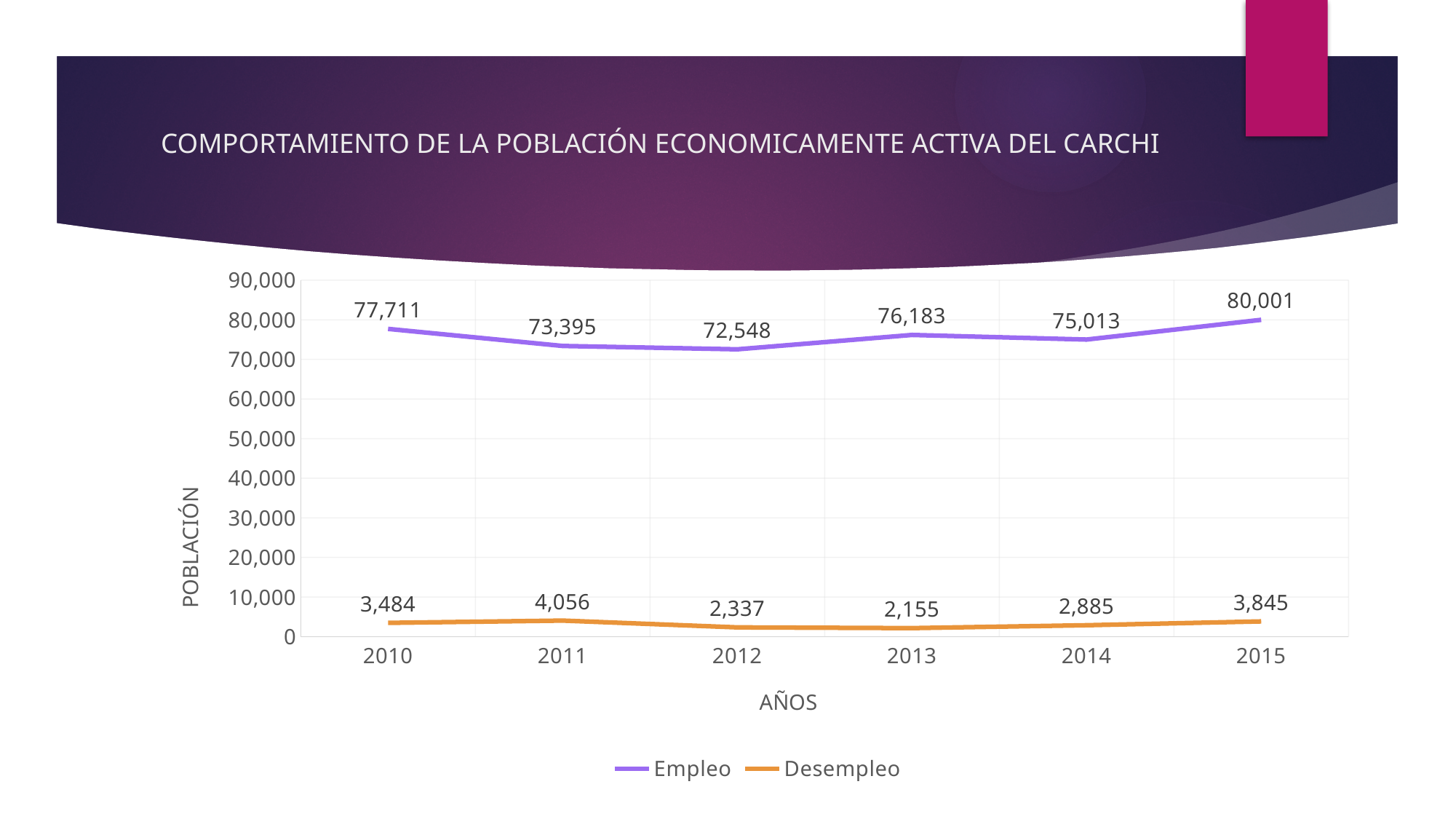
What kind of chart is shown on the slide? Line chart What is the Desempleo value for 2011? 4,056 How many series does the legend list? 2 How many years are shown on the x axis? 6 What is the Empleo value for 2015? 80,001 In which year is Desempleo highest? 2011 In which year is Desempleo lowest? 2013 Which is larger, the Empleo value for 2011 or for 2014? 2014 What is the difference between the Desempleo values for 2011 and 2013? 1,901 What is the difference between the Empleo values for 2015 and 2010? 2,290 What is the Empleo value for 2013? 76,183 In which year is Empleo lowest? 2012